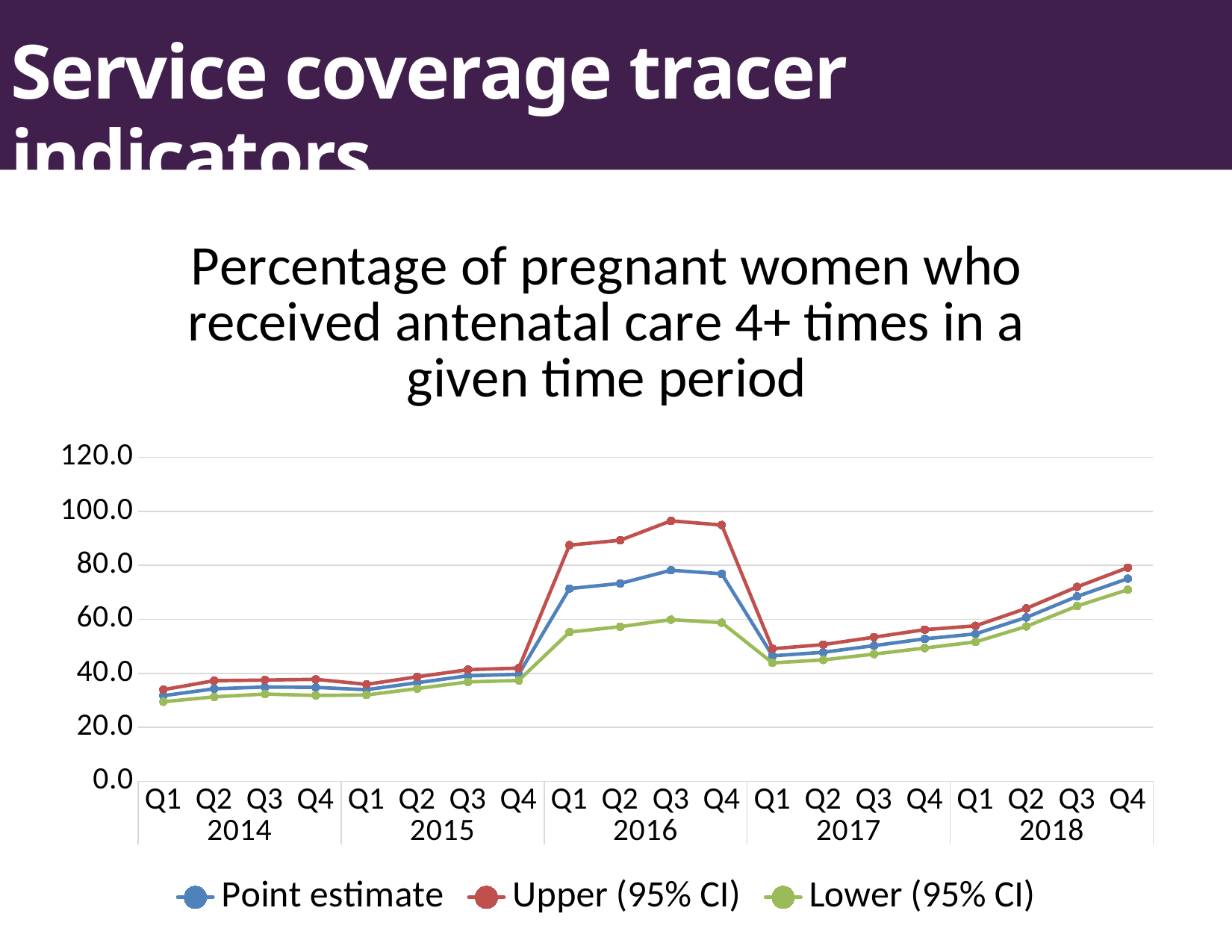
Is the Point estimate value for Q1 2014 greater or less than 40? less How many quarterly data points are plotted for each series? 20 In which quarter does the Lower (95% CI) series reach its highest value? Q4 2018 What colour is the line for the Upper (95% CI) series? Red In which quarter is the Lower (95% CI) series at its lowest value? Q1 2014 What kind of chart is shown on the slide? Line chart Which is larger for the Point estimate series: the value for Q3 2016 or the value for Q1 2017? Q3 2016 Is the Lower (95% CI) value for Q1 2017 greater or less than 60? less How many series does the legend list? 3 Is the Point estimate value for Q4 2018 greater or less than 60? greater Does the Point estimate series rise or fall across the four quarters of 2018? Rise